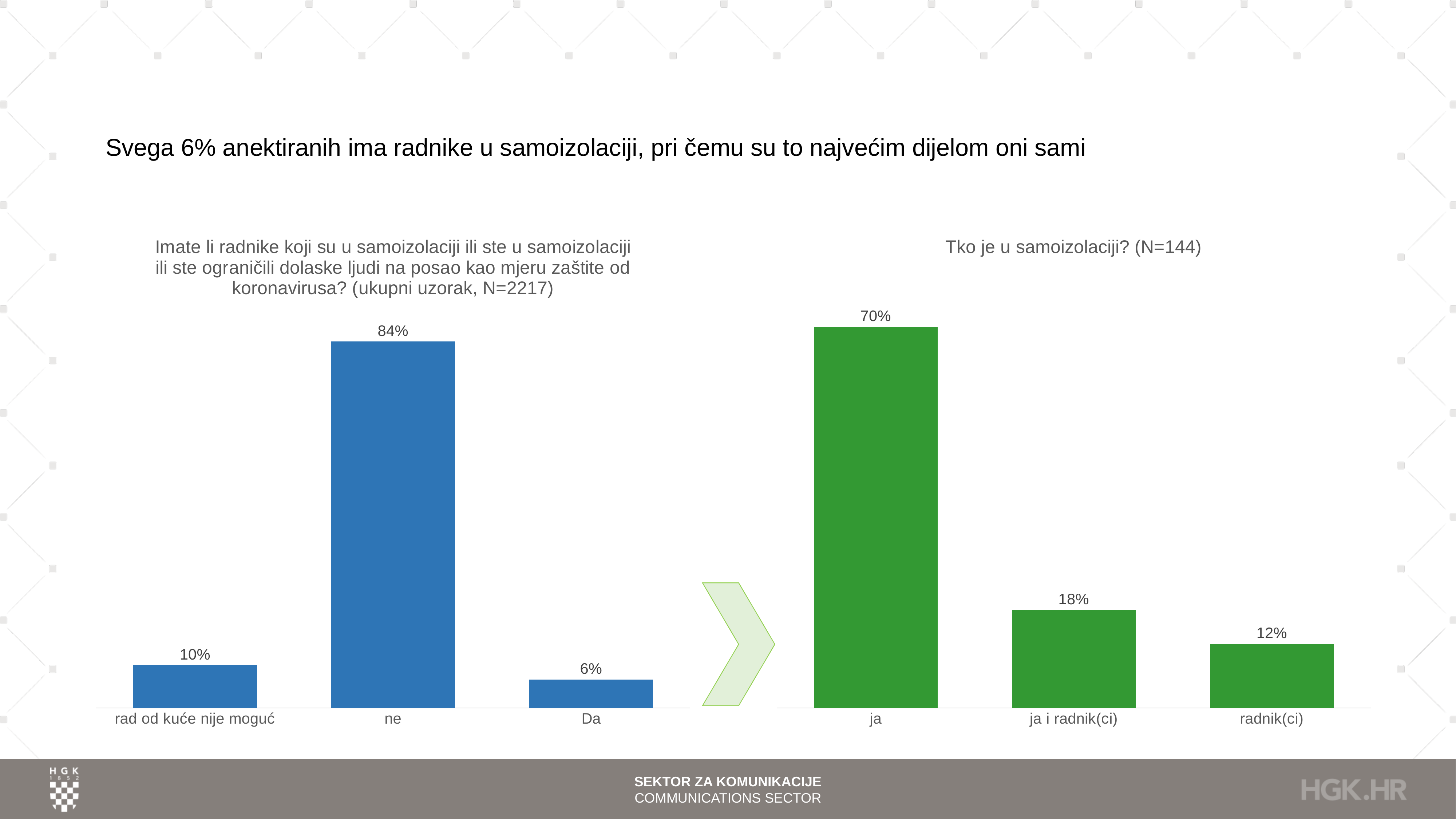
In the right chart (Tko je u samoizolaciji?), which category has the lowest value? radnik(ci) What kind of chart is the left chart (Imate li radnike koji su u samoizolaciji...)? Bar chart What is the sample size (N) stated in the title of the right chart? N=144 In the right chart (Tko je u samoizolaciji?), what is the value for "radnik(ci)"? 12% In the left chart (Imate li radnike koji su u samoizolaciji...), what is the value for "ne"? 84% In the right chart (Tko je u samoizolaciji?), what is the value for "ja"? 70% In the left chart (Imate li radnike koji su u samoizolaciji...), which is larger, the value for "rad od kuće nije moguć" or the value for "Da"? rad od kuće nije moguć In the left chart (Imate li radnike koji su u samoizolaciji...), what is the value for "rad od kuće nije moguć"? 10% In the left chart (Imate li radnike koji su u samoizolaciji...), what is the value for "Da"? 6% In the left chart (Imate li radnike koji su u samoizolaciji...), which category has the highest value? ne How many categories are shown in the right chart (Tko je u samoizolaciji?)? 3 In the right chart (Tko je u samoizolaciji?), what is the difference between the values for "ja" and "ja i radnik(ci)"? 52%